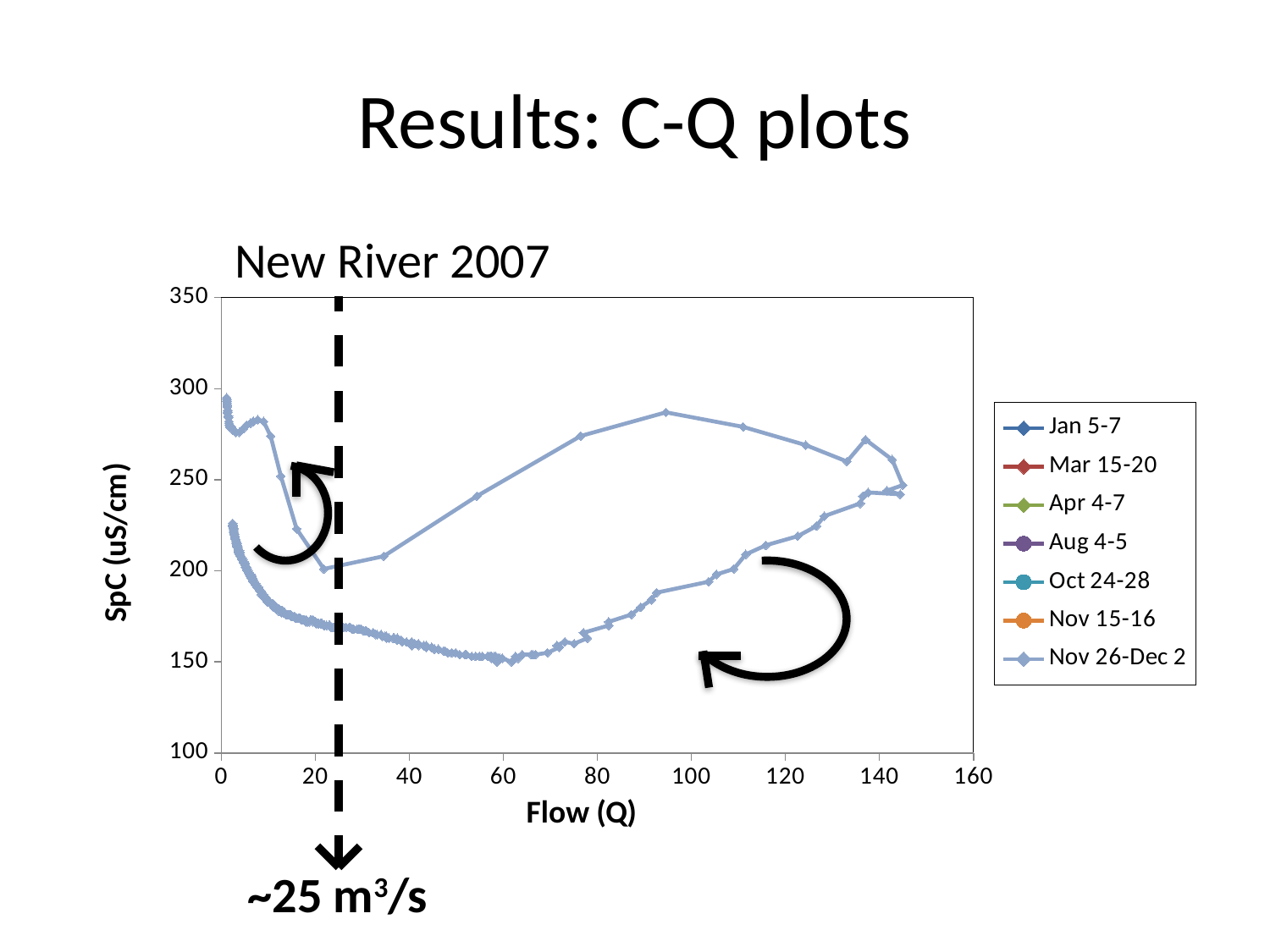
What is the highest value shown on the y axis of the New River 2007 chart? 350 Which legend entry is the last one listed in the New River 2007 chart? Nov 26-Dec 2 What kind of chart is the New River 2007 chart? Line chart What is the lowest value shown on the y axis of the New River 2007 chart? 100 What is the label of the y axis on the New River 2007 chart? SpC (uS/cm) How many series does the legend of the New River 2007 chart list? 7 Is the lowest SpC value reached by the Nov 26-Dec 2 series greater or less than 200? less What is the title of the chart on the slide? New River 2007 What is the highest value shown on the x axis of the New River 2007 chart? 160 Is the highest flow reached by the Nov 26-Dec 2 series greater or less than 120? greater Is the highest SpC value reached by the Nov 26-Dec 2 series greater or less than 250? greater